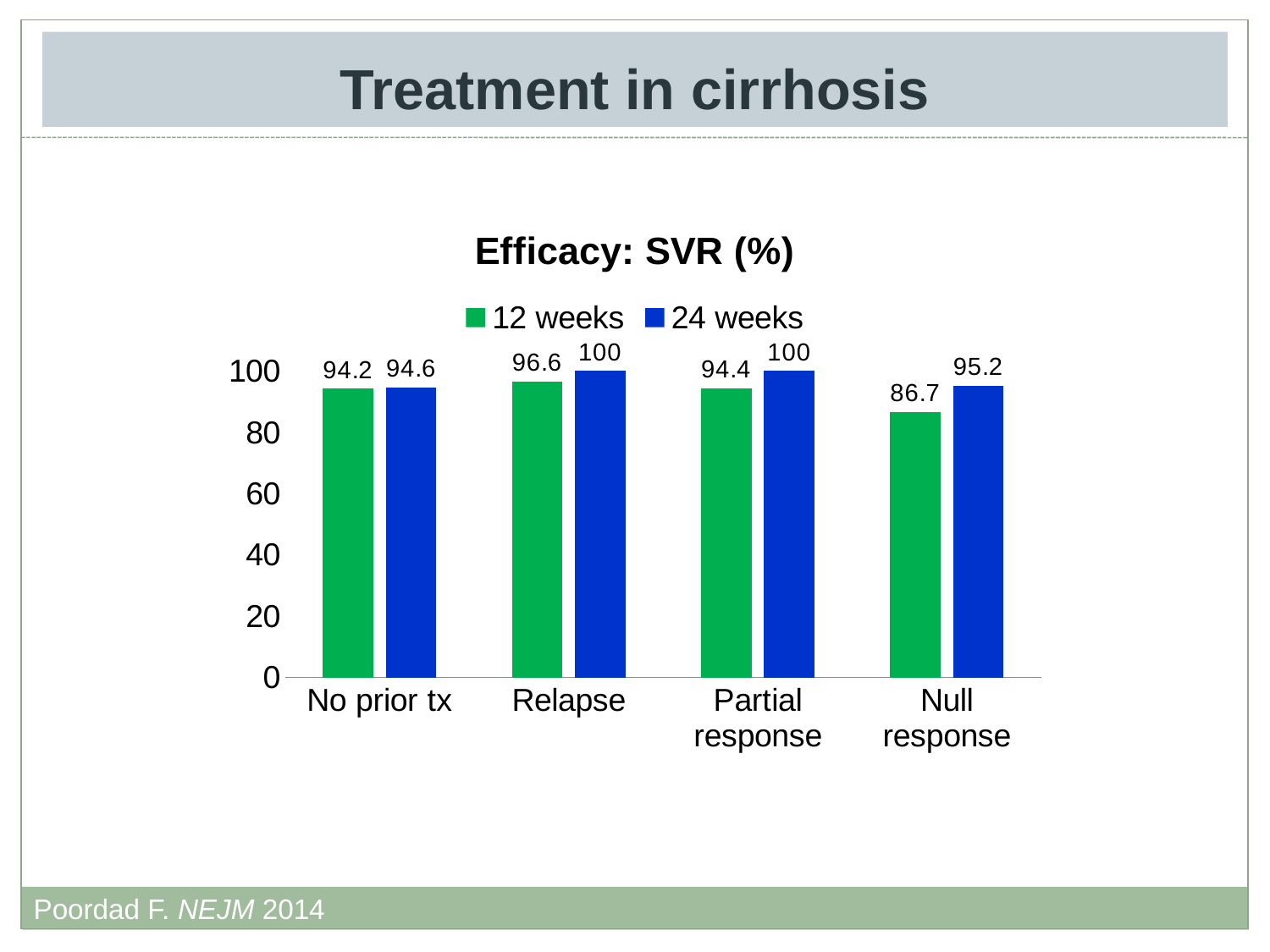
Which category has the lowest value for the 12 weeks series? Null response How many series does the legend list? 2 Which category has the highest value for the 12 weeks series? Relapse What is the SVR value for the 24 weeks series in the Null response category? 95.2 What is the difference between the 24 weeks and 12 weeks values in the Null response category? 8.5 What is the SVR value for the 12 weeks series in the Relapse category? 96.6 Which is larger: the 12 weeks value for Null response or the 12 weeks value for Partial response? Partial response What is the SVR value for the 12 weeks series in the No prior tx category? 94.2 How many categories are shown on the x axis? 4 What kind of chart is shown on the slide? Bar chart What is the difference between the 24 weeks and 12 weeks values in the Partial response category? 5.6 What is the title of the chart? Efficacy: SVR (%)